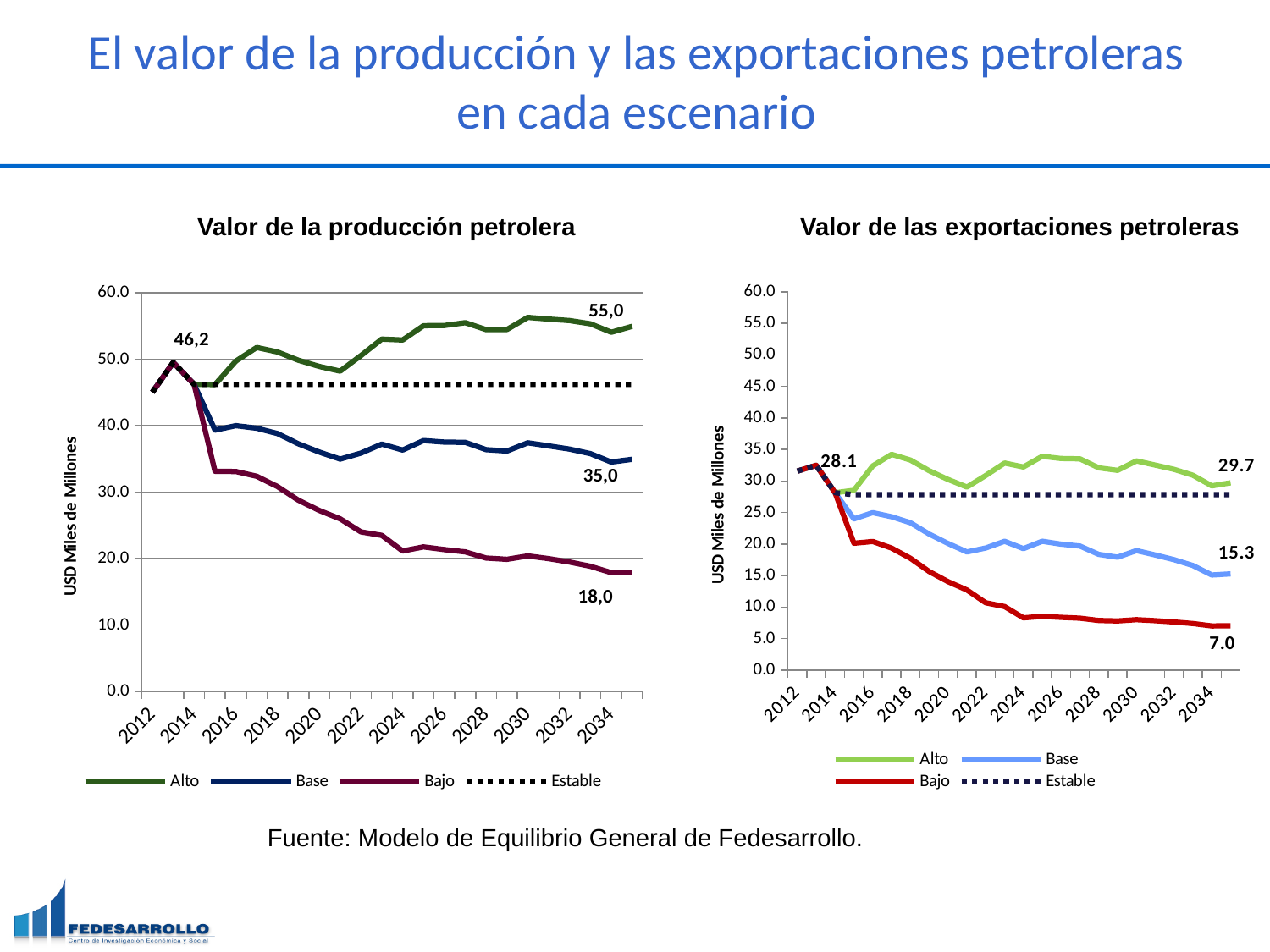
What kind of chart is 'Valor de la producción petrolera'? Line chart In the 'Valor de la producción petrolera' chart, what value is labelled for the Estable series? 46,2 In the 'Valor de las exportaciones petroleras' chart, is the value of the Base series in 2022 greater or less than 25.0? less In the 'Valor de la producción petrolera' chart, what is the difference between the labelled end values of the Alto and Base series? 20,0 In the 'Valor de las exportaciones petroleras' chart, what value is labelled at the end of the Bajo series? 7.0 In the 'Valor de las exportaciones petroleras' chart, does the Bajo series rise or fall from 2012 to 2034? Fall How many series does the legend of the 'Valor de las exportaciones petroleras' chart list? 4 In the 'Valor de las exportaciones petroleras' chart, what is the difference between the labelled end values of the Alto and Bajo series? 22.7 In the 'Valor de las exportaciones petroleras' chart, what value is labelled at the end of the Base series? 15.3 In the 'Valor de la producción petrolera' chart, what value is labelled at the end of the Alto series? 55,0 In the 'Valor de la producción petrolera' chart, which series has the highest value in 2034? Alto In the 'Valor de la producción petrolera' chart, what value is labelled at the end of the Bajo series? 18,0